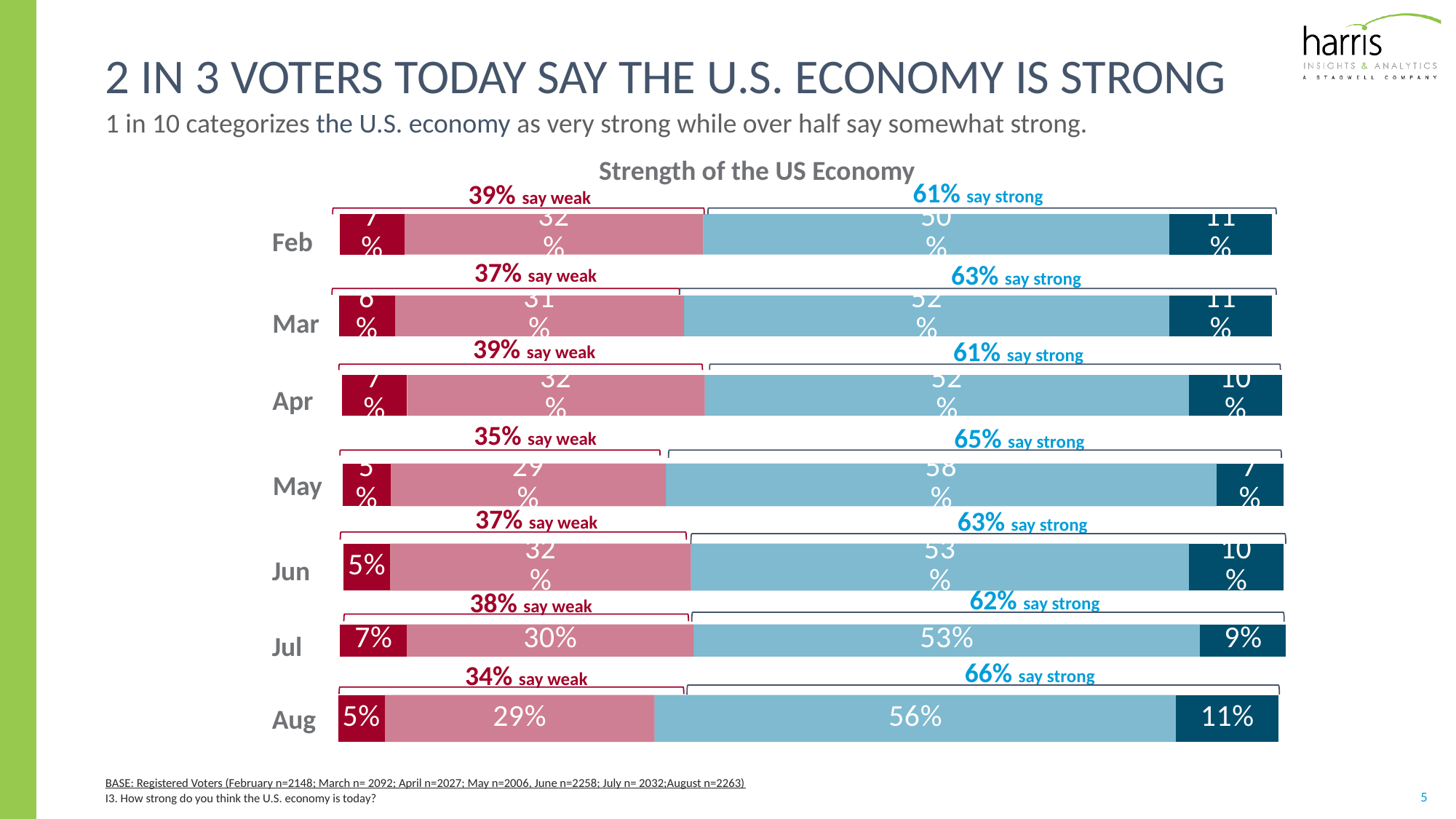
In Aug, how many percentage points higher is the share saying strong than the share saying weak? 32 What kind of chart is shown on the slide? Stacked bar chart Which month has a larger share saying the economy is strong, Jul or Aug? Aug Which month has the highest share saying the economy is strong? Aug What is the value of the light blue segment for Aug? 56% What is the value of the dark blue segment for Jul? 9% Which month has the lowest share saying the economy is weak? Aug What percentage of voters say the economy is weak in Jul? 38% How many months are shown in the Strength of the US Economy chart? 7 What is the value of the dark red segment for Jul? 7% What is the title of the chart? Strength of the US Economy What percentage of voters say the economy is strong in Aug? 66%